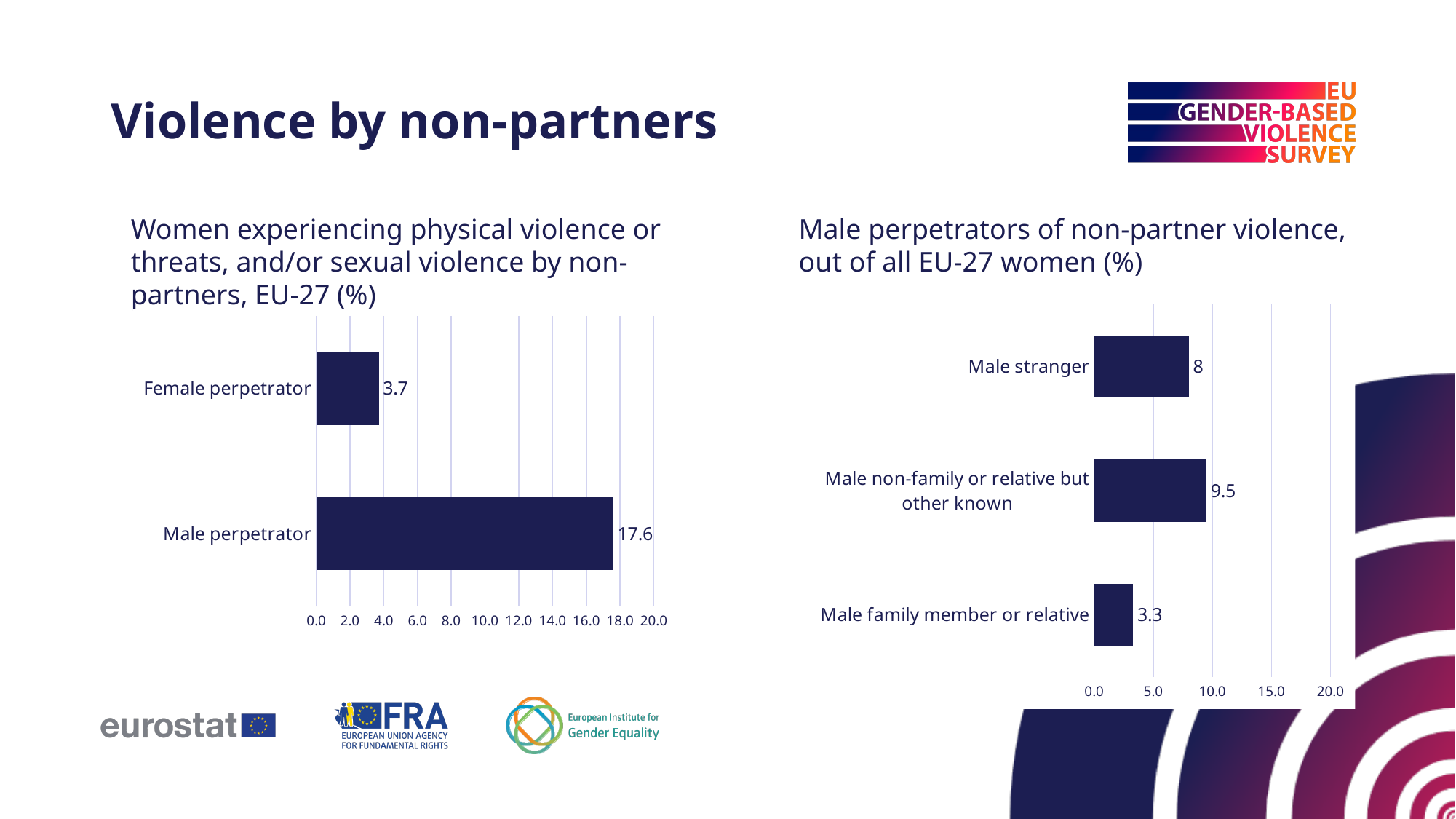
In the right chart, which category has the highest value? Male non-family or relative but other known In the right chart (Male perpetrators of non-partner violence), what is the value for Male stranger? 8 In the left chart (Women experiencing physical violence or threats, and/or sexual violence by non-partners), what is the value for Female perpetrator? 3.7 What kind of chart is the left chart? Bar chart In the left chart, what is the difference between the Male perpetrator and Female perpetrator values? 13.9 In the right chart, how many categories are shown? 3 In the left chart, how many categories are shown? 2 In the right chart (Male perpetrators of non-partner violence), what is the value for Male family member or relative? 3.3 In the right chart (Male perpetrators of non-partner violence), what is the value for Male non-family or relative but other known? 9.5 In the left chart (Women experiencing physical violence or threats, and/or sexual violence by non-partners), what is the value for Male perpetrator? 17.6 In the right chart, what is the difference between the values for Male non-family or relative but other known and Male stranger? 1.5 In the right chart, which category has the lowest value? Male family member or relative